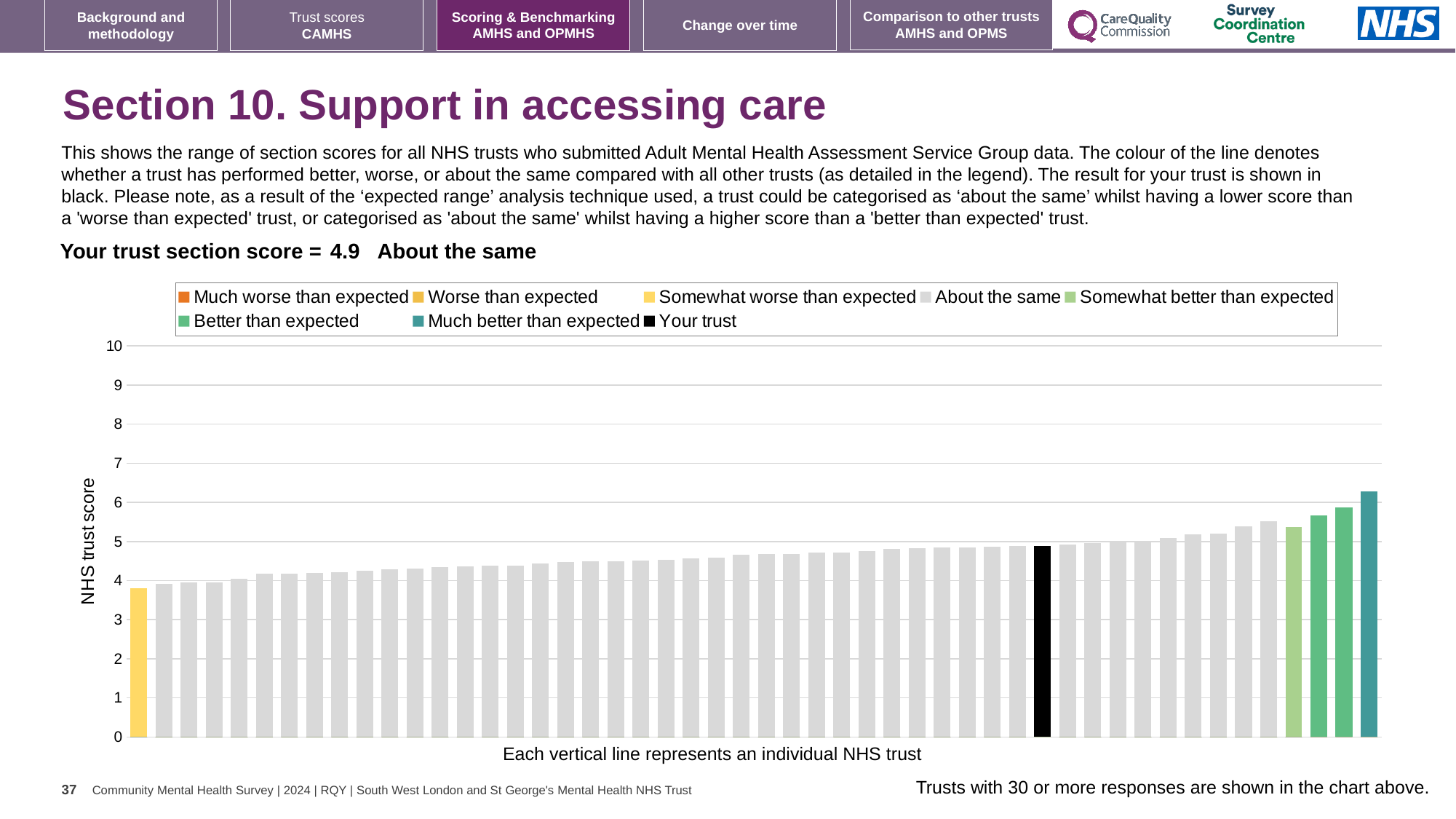
Is the value of the leftmost (lowest) bar greater or less than 5? less Is your trust's bar higher or lower than the tallest bar in the chart? lower Is the value for your trust (black bar) greater or less than 4? greater How many entries does the chart legend list? 8 What kind of chart is shown on the slide? bar chart What is the label on the vertical axis of the chart? NHS trust score What colour is the bar representing your trust? black Do the bar values rise or fall from left to right across the chart? rise Is the value of the tallest bar greater or less than 5? greater Which comparison category is your trust placed in for this section? About the same Which legend category does the tallest bar belong to? Much better than expected What is your trust's section score for Support in accessing care? 4.9